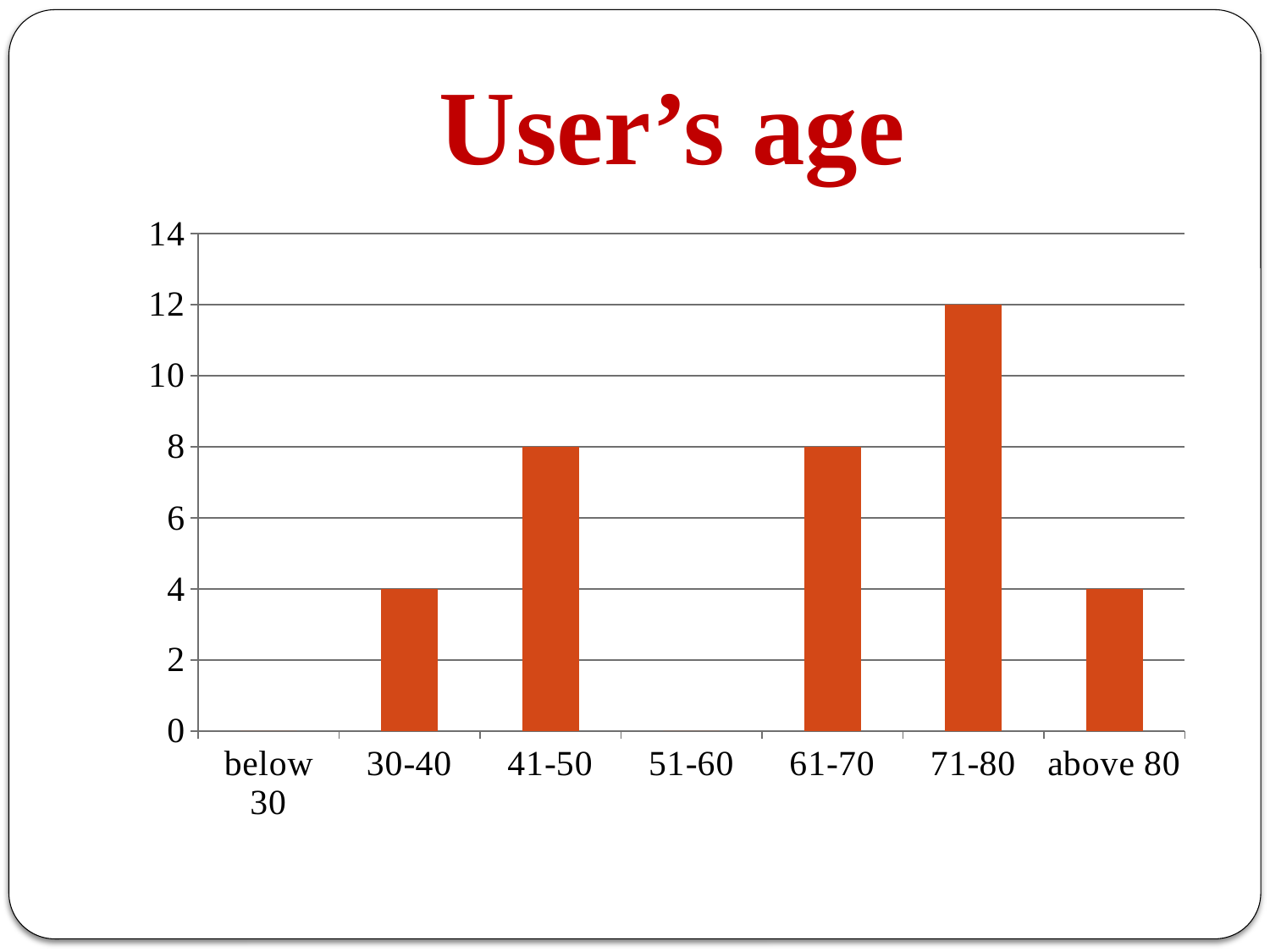
What is the difference between the values for 71-80 and above 80? 8 Which age group has the highest value? 71-80 Which is larger, the value for 61-70 or the value for above 80? 61-70 What is the value for the 71-80 age group? 12 What is the value for the 30-40 age group? 4 Which age groups have no bar shown (a value of 0)? below 30 and 51-60 How many age categories are shown on the x axis? 7 What is the title of the chart? User's age What is the value for the 41-50 age group? 8 What is the maximum value shown on the y axis? 14 What kind of chart is shown on the slide? bar chart Is the value for 71-80 greater or less than 10? greater